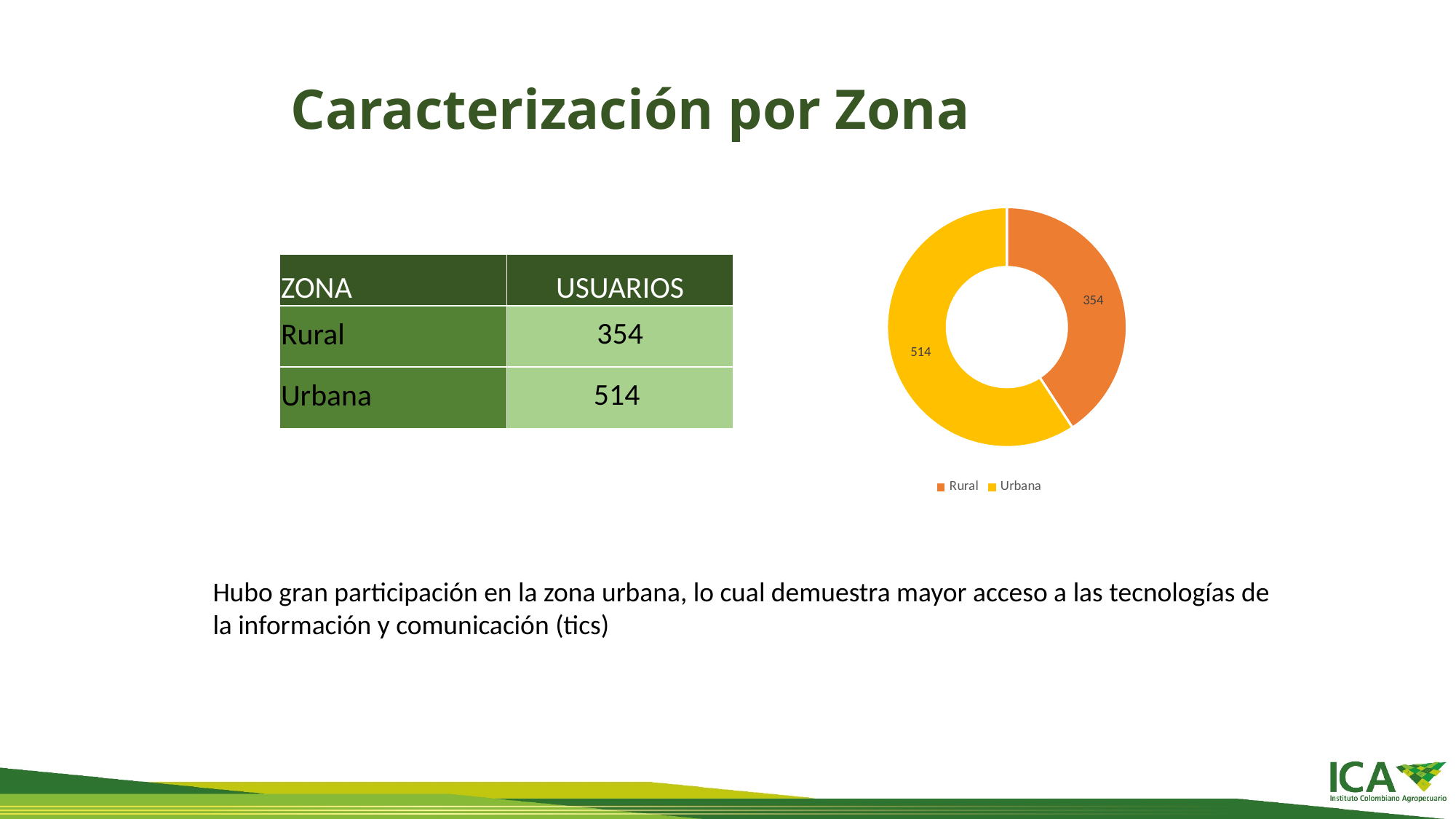
What colour is the Rural slice in the chart? Orange Which zone has the largest slice in the chart? Urbana What is the total of the two values shown in the chart? 868 What is the difference between the Urbana and Rural values in the chart? 160 Which zone has the smallest slice in the chart? Rural What colour is the Urbana slice in the chart? Yellow How many slices does the doughnut chart have? 2 What is the value for Urbana in the doughnut chart? 514 What kind of chart is shown on the slide? Doughnut chart What is the value for Rural in the doughnut chart? 354 Which is larger in the chart, Rural or Urbana? Urbana How many entries does the chart legend list? 2